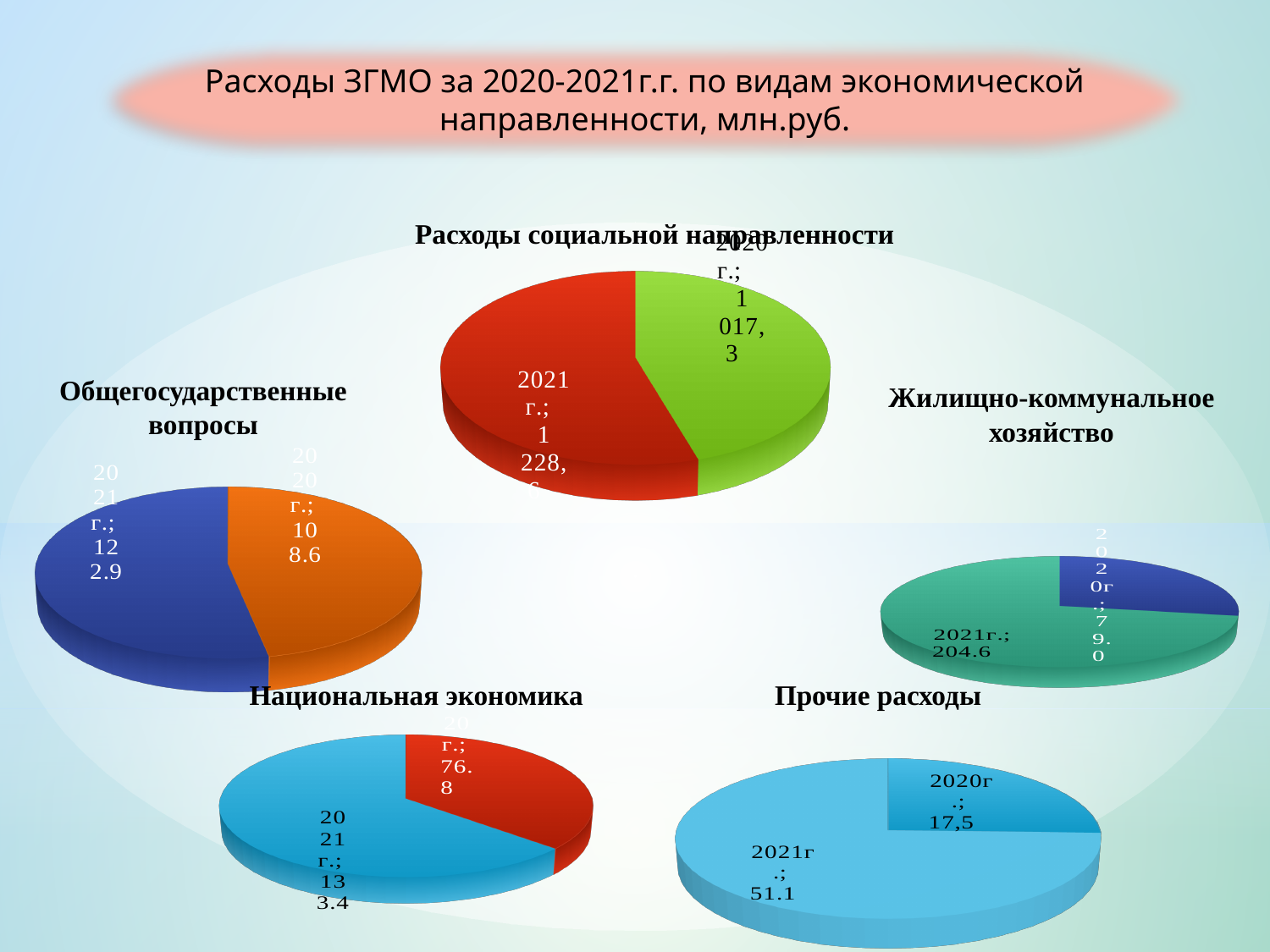
What kind of charts are shown on the slide? Pie charts In the 'Жилищно-коммунальное хозяйство' chart, what is the value for 2021г.? 204.6 In the 'Национальная экономика' chart, what is the value for 2021 г.? 133.4 In the 'Жилищно-коммунальное хозяйство' chart, which year has the larger slice, 2020г. or 2021г.? 2021г. In the 'Национальная экономика' chart, what is the value for 2020 г.? 76.8 In the 'Общегосударственные вопросы' chart, what is the value for 2020 г.? 108.6 In the 'Прочие расходы' chart, what is the value for 2021г.? 51.1 In the 'Прочие расходы' chart, what is the value for 2020г.? 17,5 In the 'Расходы социальной направленности' chart, what is the value for 2020 г.? 1 017,3 How many pie charts are on the slide? 5 In the 'Национальная экономика' chart, what is the difference between the 2021 г. and 2020 г. values? 56.6 In the 'Расходы социальной направленности' chart, which year has the larger slice, 2020 г. or 2021 г.? 2021 г.